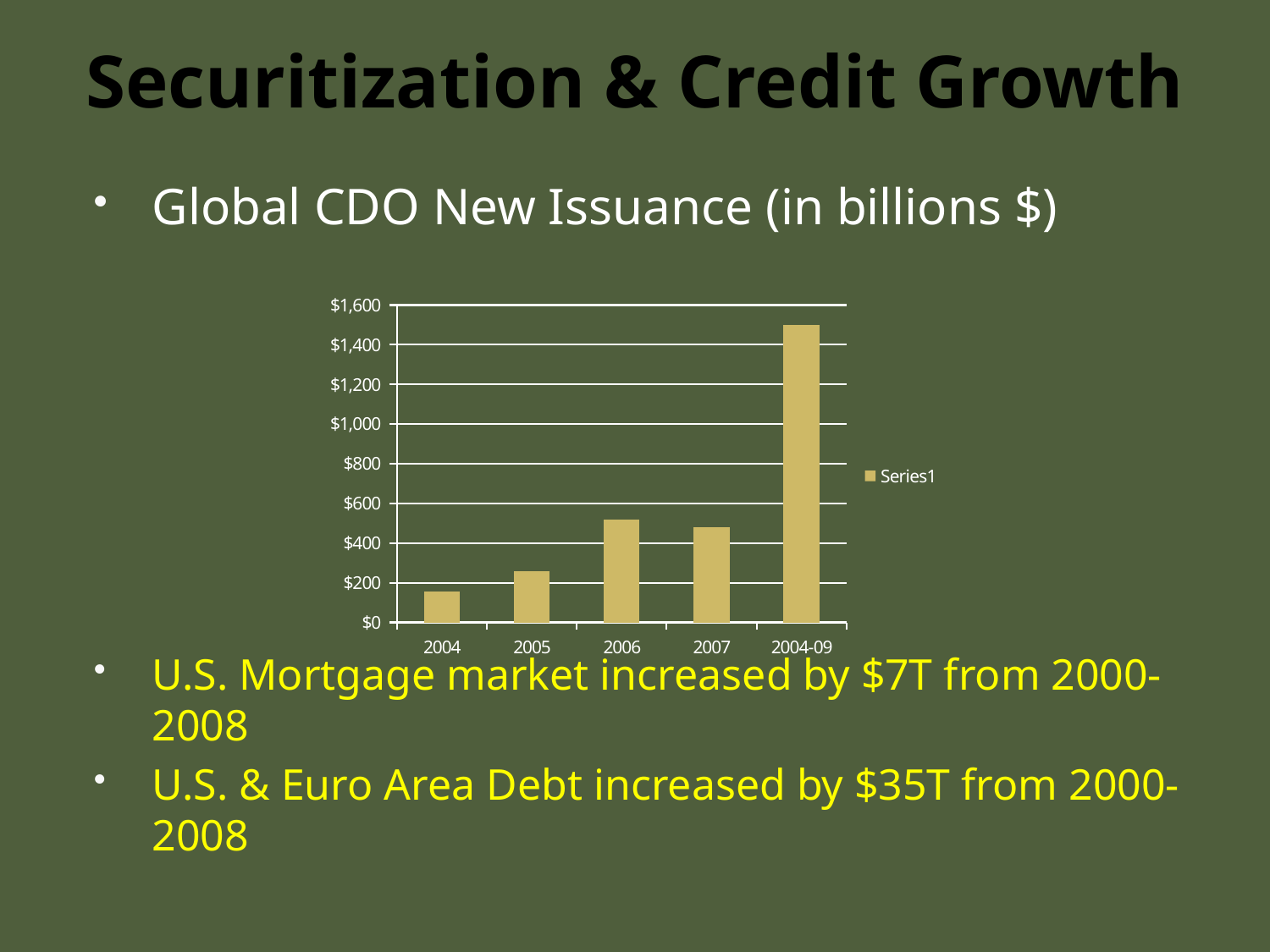
Which category has the lowest bar in the chart? 2004 Is the value for 2004-09 greater or less than $1,400? greater Which is larger, the value for 2005 or the value for 2006? 2006 How many series does the chart's legend list? 1 Is the value for 2006 greater or less than $400? greater Is the value for 2005 greater or less than $200? greater Do the values rise or fall from 2004 to 2006? rise Which category has the highest bar in the chart? 2004-09 What is the name of the series shown in the chart's legend? Series1 How many categories are shown on the x axis of the chart? 5 What kind of chart is shown on the slide? bar chart